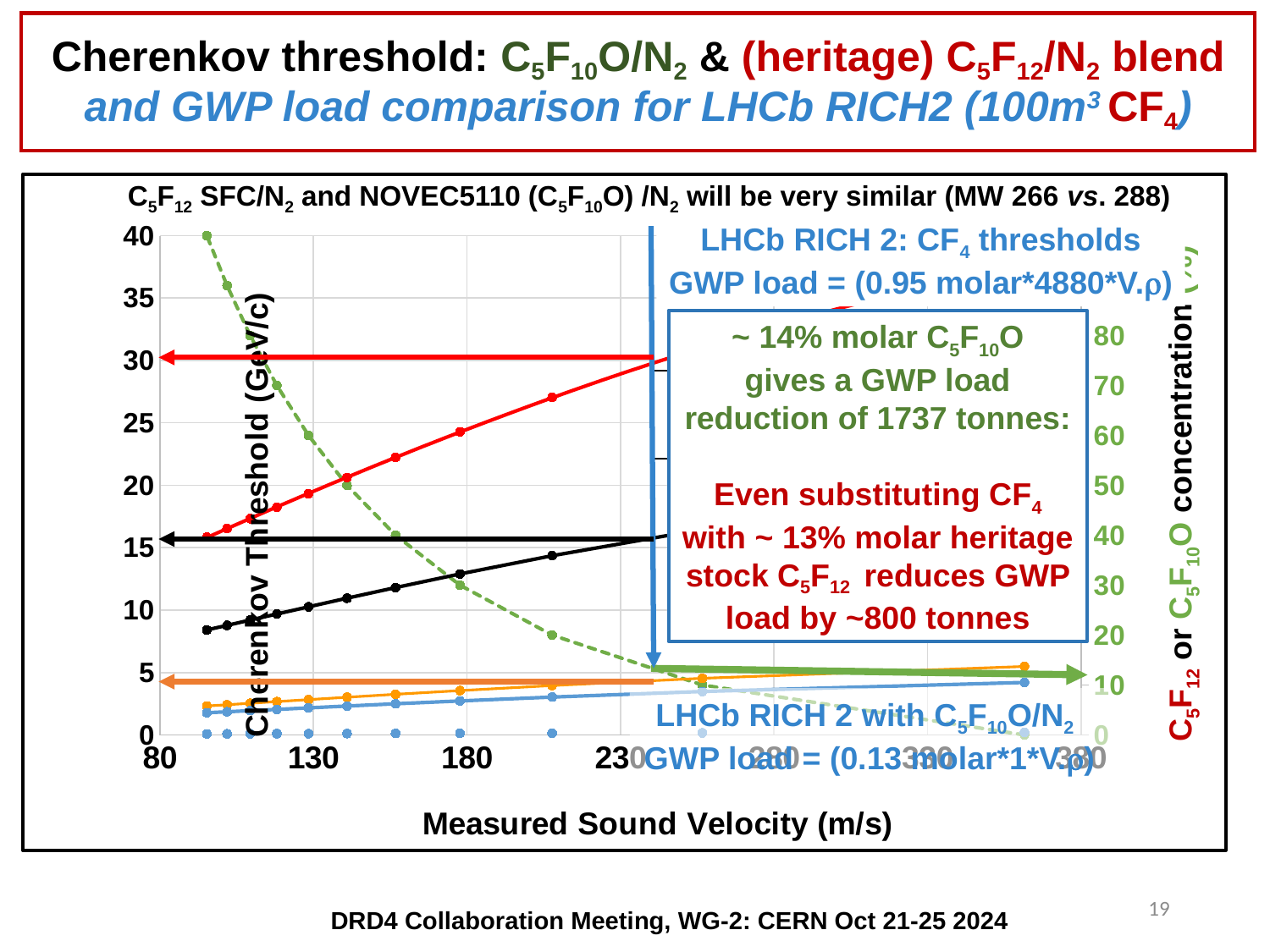
At a measured sound velocity of 130 m/s, is the Cherenkov threshold on the red solid line greater or less than 15 GeV/c? greater What kind of chart is shown on the slide? line chart Does the black solid line rise or fall as the measured sound velocity increases? rise At a measured sound velocity of 230 m/s, is the Cherenkov threshold on the black solid line greater or less than 20 GeV/c? less At a measured sound velocity of 130 m/s, is the concentration on the green dashed line (right axis) greater or less than 50%? greater Does the green dashed line rise or fall as the measured sound velocity increases? fall Does the red solid line rise or fall as the measured sound velocity increases? rise What is the label of the x axis of the chart? Measured Sound Velocity (m/s) What is the label of the left y axis of the chart? Cherenkov Threshold (GeV/c) At a measured sound velocity of 180 m/s, which line shows the higher Cherenkov threshold, the red solid line or the black solid line? red solid line